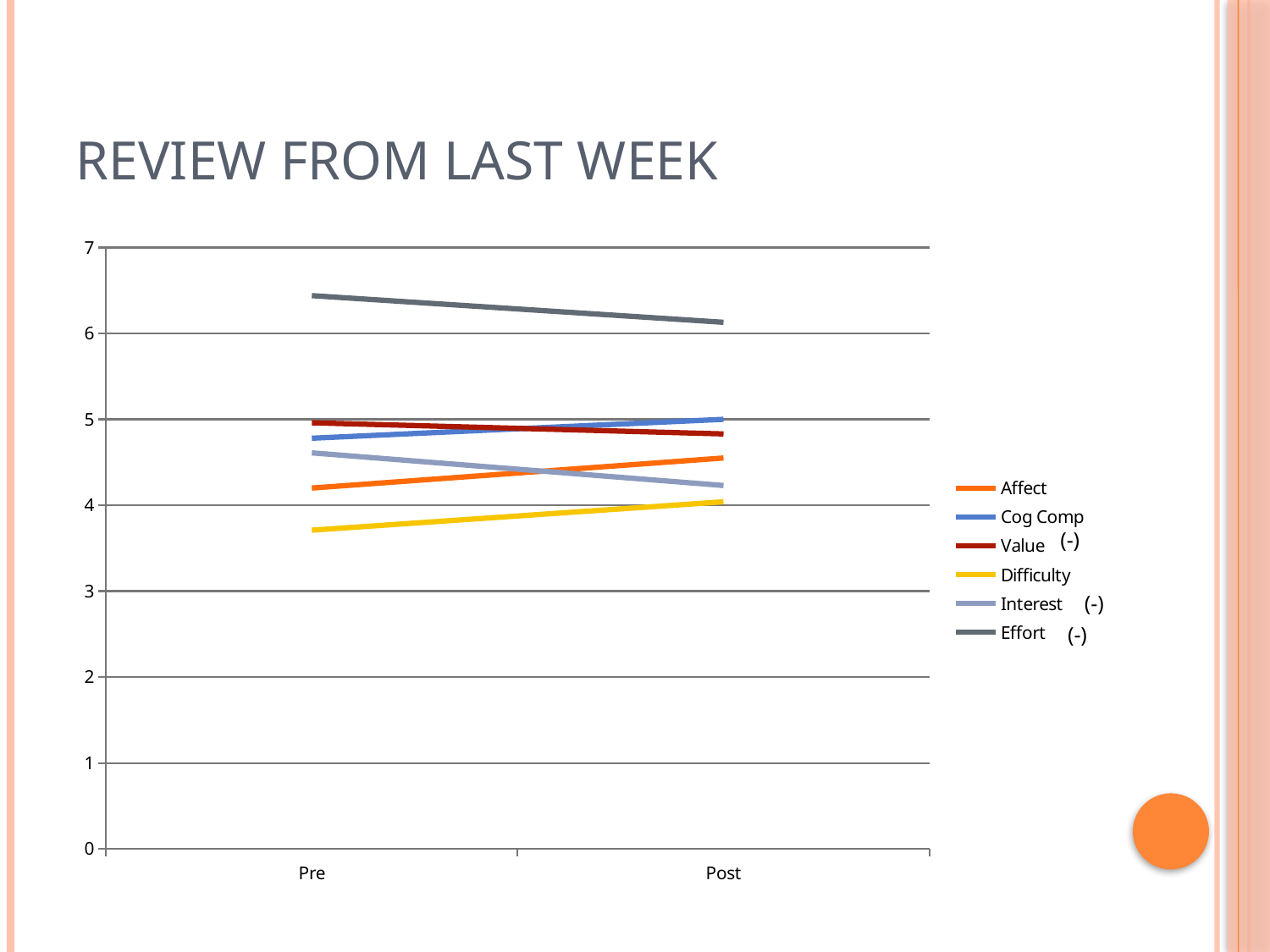
What is the title of the slide containing the chart? REVIEW FROM LAST WEEK Does the Difficulty line rise or fall from Pre to Post? Rise Which series has the lowest value at Pre? Difficulty How many series does the legend list? 6 Does the Interest line rise or fall from Pre to Post? Fall How many categories are shown on the x axis? 2 Does the Effort line rise or fall from Pre to Post? Fall Is the value for Effort at Pre greater or less than 6? greater Is the value for Difficulty at Pre greater or less than 4? less At Post, which is larger: Affect or Difficulty? Affect Which series has the highest values at both Pre and Post? Effort What kind of chart is shown on the slide? Line chart